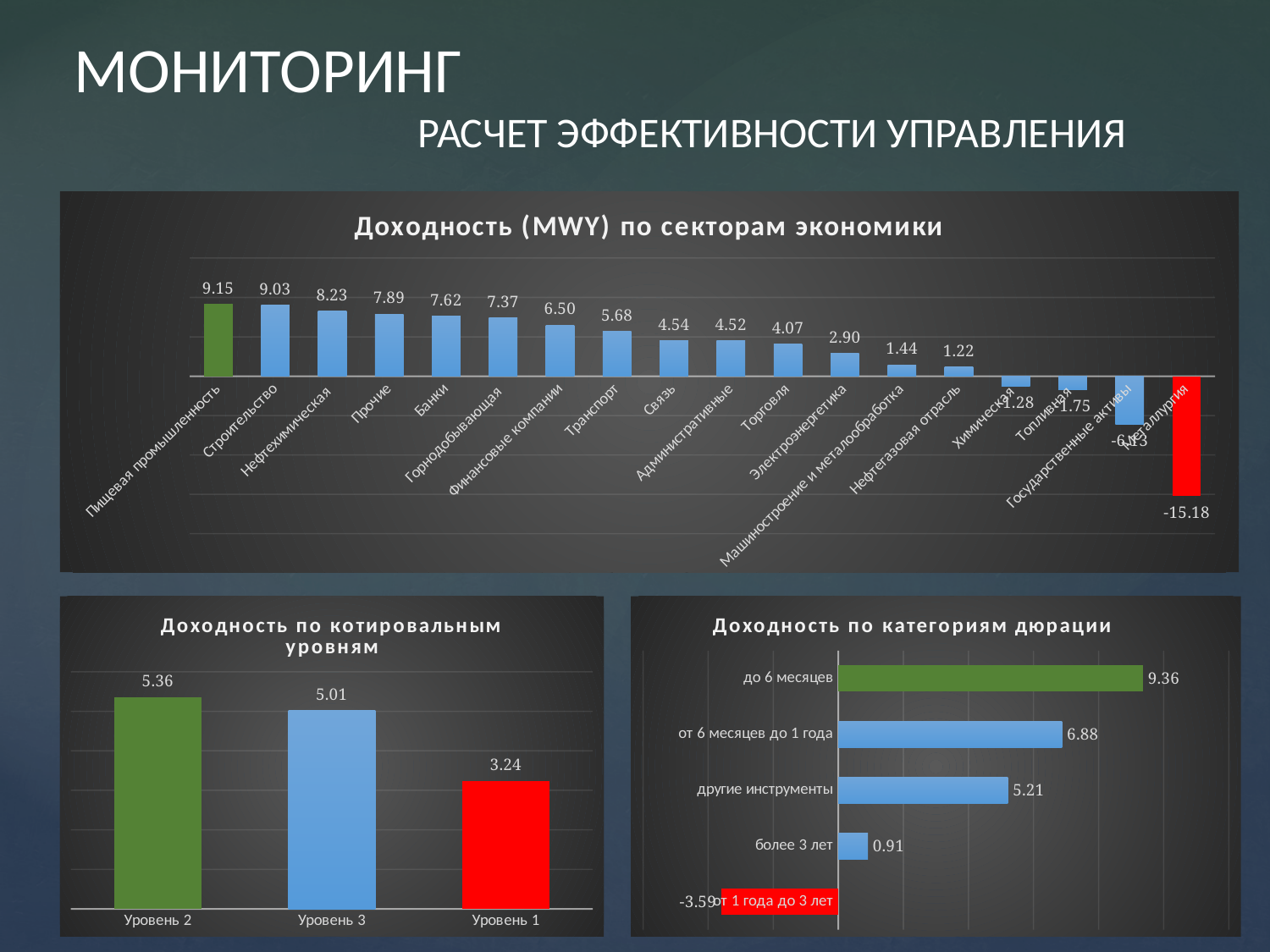
In the chart 'Доходность (MWY) по секторам экономики', what is the value for Металлургия? -15.18 In the chart 'Доходность по котировальным уровням', what is the difference between Уровень 2 and Уровень 3? 0.35 In the chart 'Доходность (MWY) по секторам экономики', which sector has the lowest value? Металлургия In the chart 'Доходность по категориям дюрации', which category has the lowest value? от 1 года до 3 лет In the chart 'Доходность по котировальным уровням', what is the value for Уровень 1? 3.24 In the chart 'Доходность (MWY) по секторам экономики', which sector has the highest value? Пищевая промышленность In the chart 'Доходность (MWY) по секторам экономики', what is the value for Строительство? 9.03 In the chart 'Доходность по котировальным уровням', how many categories are shown? 3 In the chart 'Доходность (MWY) по секторам экономики', what is the difference between the values for Банки and Транспорт? 1.94 In the chart 'Доходность (MWY) по секторам экономики', which is larger: Связь or Торговля? Связь In the chart 'Доходность по категориям дюрации', what is the value for 'от 6 месяцев до 1 года'? 6.88 What kind of chart is 'Доходность по категориям дюрации'? Bar chart